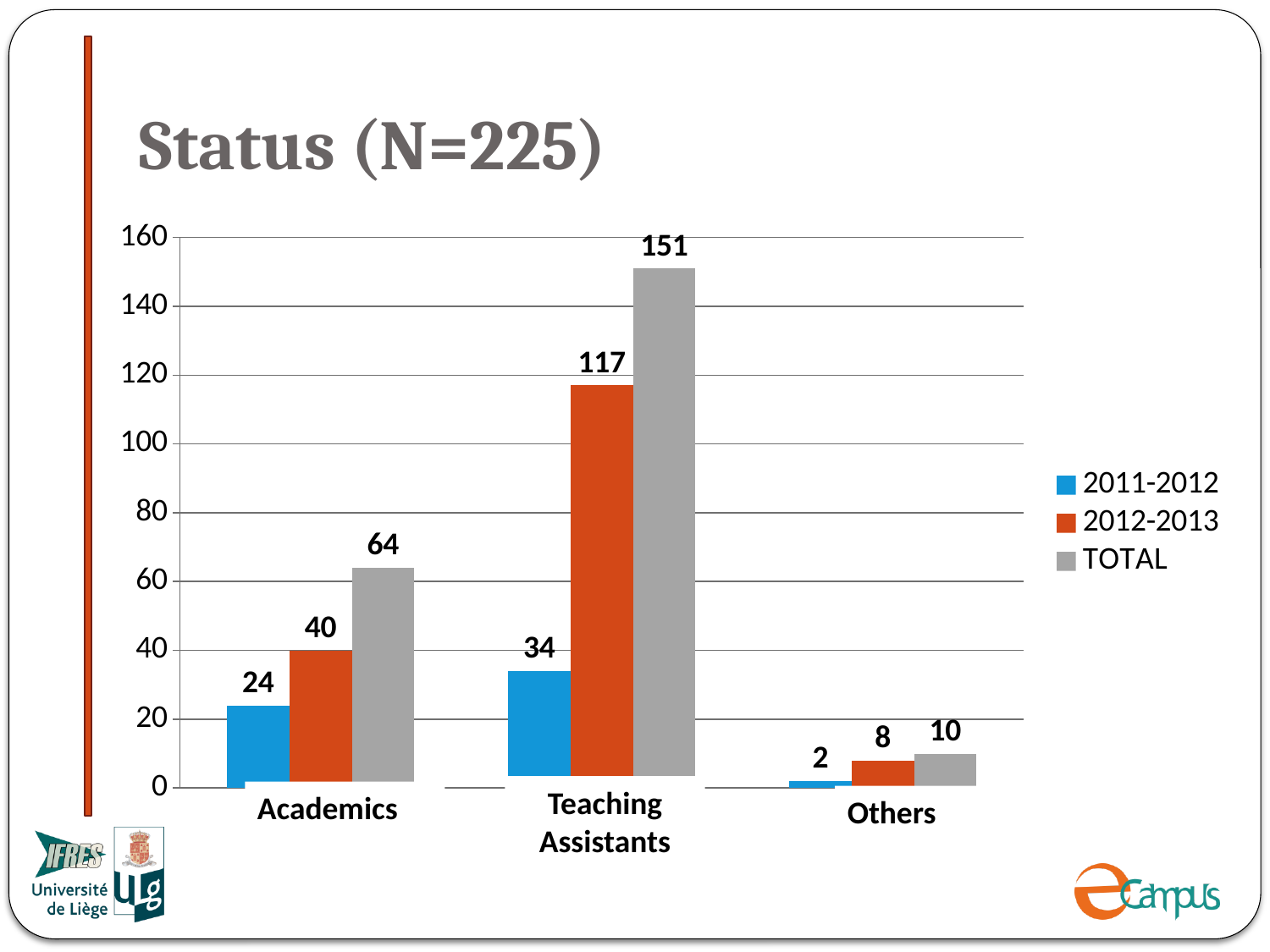
What is the value for Others in the 2012-2013 series? 8 How many categories are shown on the x axis? 3 What is the TOTAL value for Teaching Assistants? 151 Is the TOTAL value for Academics greater or less than 60? greater What kind of chart is shown on the slide? bar chart Which category has the highest TOTAL value? Teaching Assistants What is the value for Academics in the 2011-2012 series? 24 Which category has the lowest value in the 2011-2012 series? Others How many series does the legend list? 3 What is the title of the slide containing the chart? Status (N=225) What is the difference between the 2012-2013 and 2011-2012 values for Teaching Assistants? 83 Which is larger: the 2012-2013 value for Academics or the 2011-2012 value for Teaching Assistants? 2012-2013 value for Academics